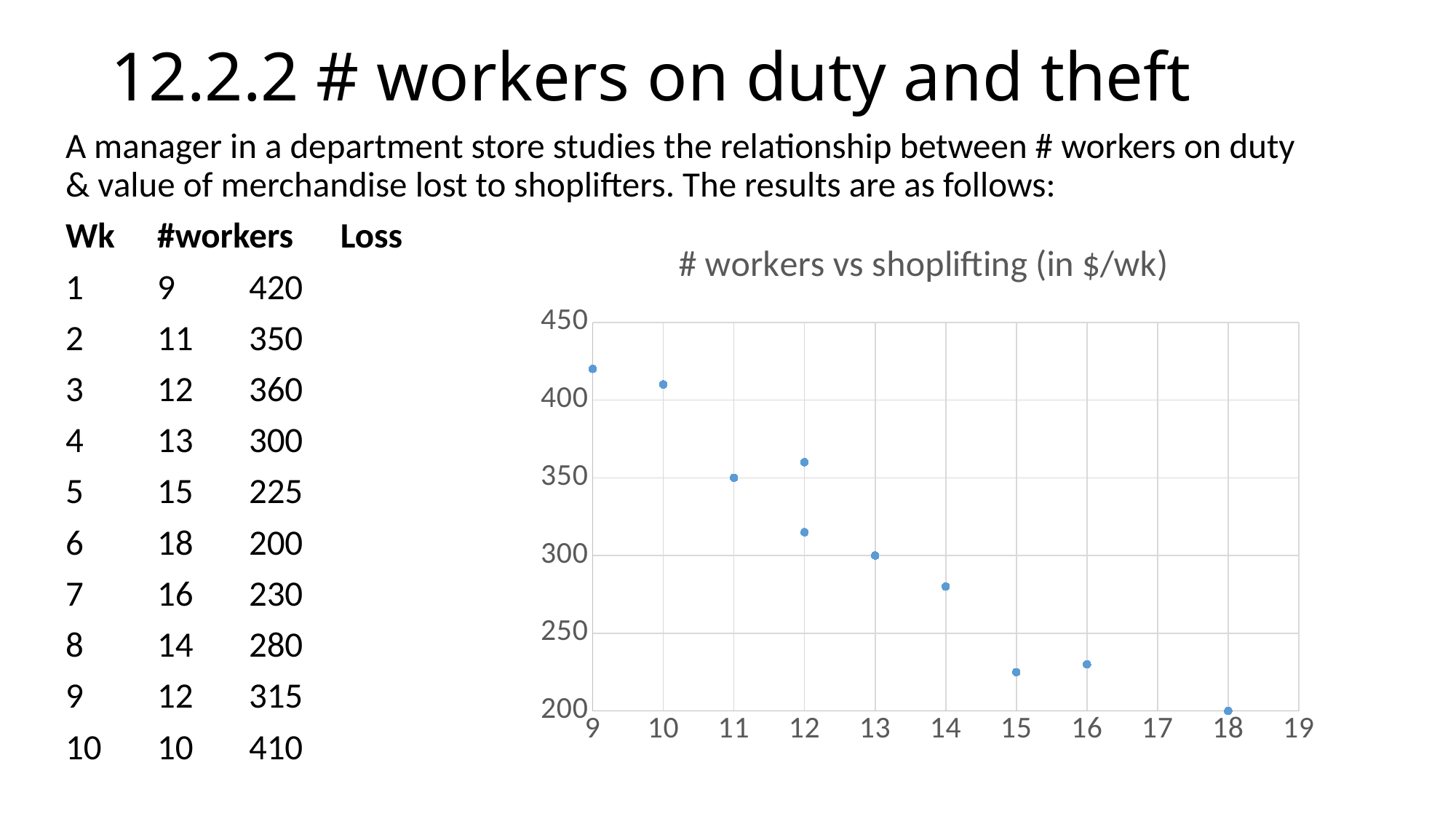
What is the loss value plotted for 18 workers? 200 Is the loss value for 14 workers greater or less than 300? less Do the plotted loss values generally rise or fall as the number of workers increases along the x axis? fall At which number of workers is the plotted loss lowest? 18 What is the loss value plotted for 13 workers? 300 What kind of chart is shown on the slide? scatter chart What is the title of the chart? # workers vs shoplifting (in $/wk) Is the loss value for 10 workers greater or less than 400? greater How many data points are plotted in the chart? 10 What is the difference between the loss at 9 workers and the loss at 18 workers? 220 At which number of workers is the plotted loss highest? 9 What is the loss value plotted for 11 workers? 350